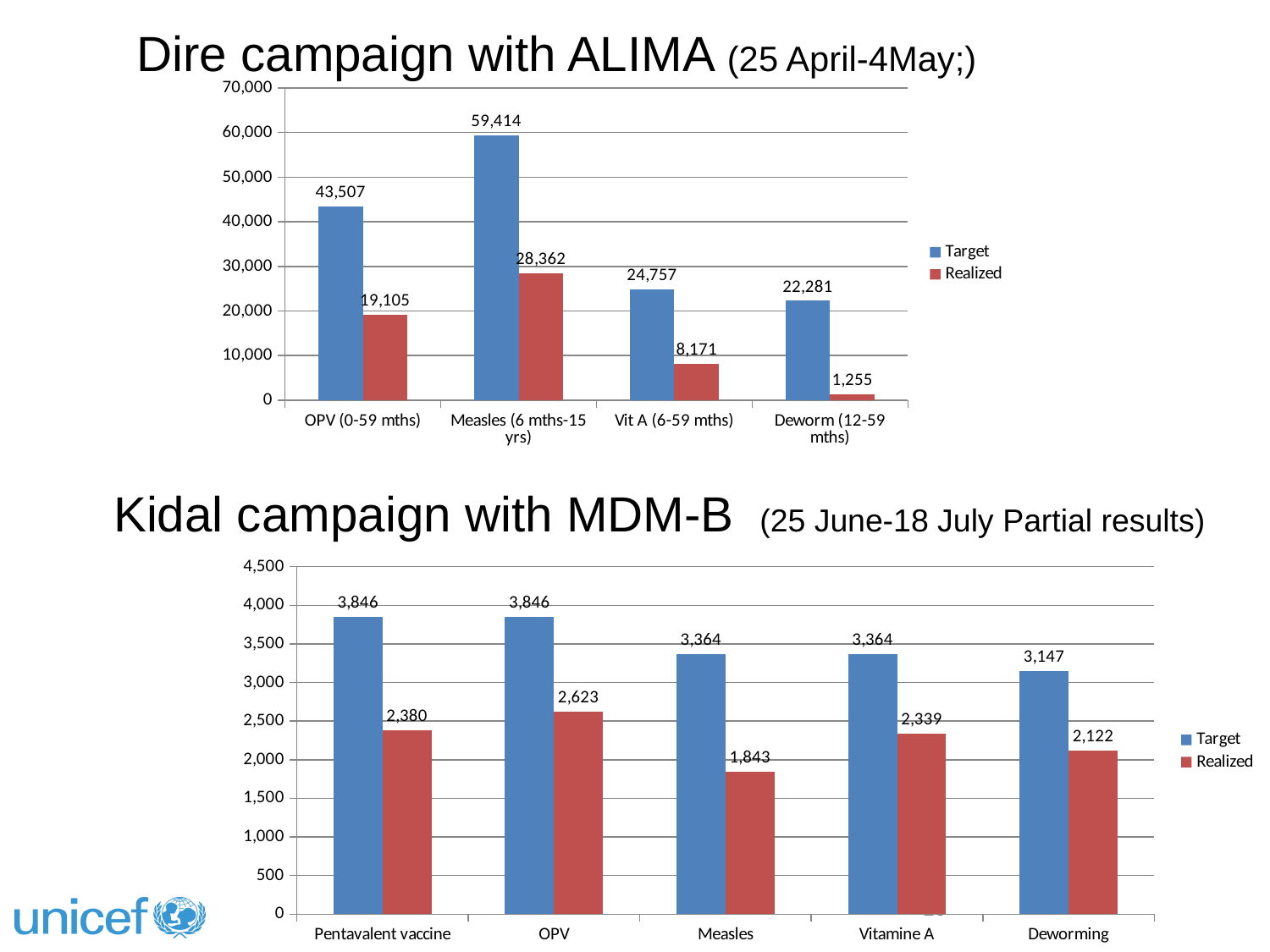
In the Dire campaign with ALIMA chart, which category has the highest Target value? Measles (6 mths-15 yrs) In the Dire campaign with ALIMA chart, what is the Target value for Measles (6 mths-15 yrs)? 59,414 In the Kidal campaign with MDM-B chart, what is the Target value for Deworming? 3,147 What type of chart is the Kidal campaign with MDM-B chart? bar chart In the Dire campaign with ALIMA chart, what is the difference between the Target and Realized values for OPV (0-59 mths)? 24,402 In the Kidal campaign with MDM-B chart, what is the Realized value for OPV? 2,623 In the Dire campaign with ALIMA chart, how many categories are shown on the x axis? 4 In the Kidal campaign with MDM-B chart, how many series does the legend list? 2 In the Dire campaign with ALIMA chart, what is the Realized value for Deworm (12-59 mths)? 1,255 In the Kidal campaign with MDM-B chart, is the Realized value for Pentavalent vaccine larger or smaller than the Realized value for Vitamine A? larger In the Dire campaign with ALIMA chart, which category has the lowest Realized value? Deworm (12-59 mths) In the Kidal campaign with MDM-B chart, which category has the lowest Realized value? Measles